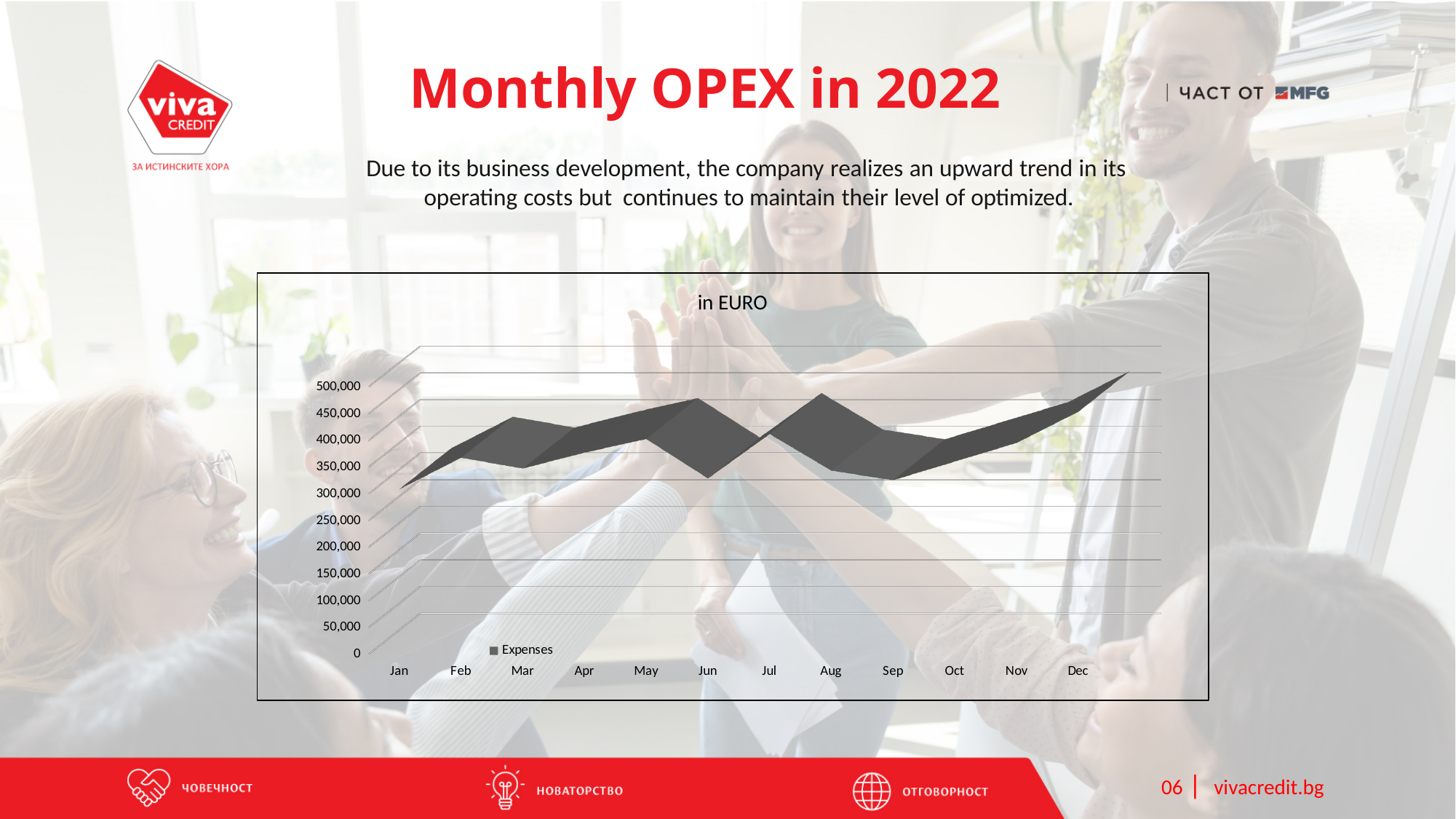
Which month has higher expenses, Jan or Dec? Dec Is the value for Sep greater or less than 450,000? less What is the name of the series shown in the chart's legend? Expenses What kind of chart is shown on the slide? line chart What is the title printed above the chart's plot area? in EURO Is the value for Mar greater or less than 300,000? greater How many series does the chart's legend list? 1 How many months are plotted on the x axis of the chart? 12 Which month has the highest expenses in the chart? Dec Is the value for Jan greater or less than 400,000? less Overall, do expenses rise or fall from Jan to Dec? rise